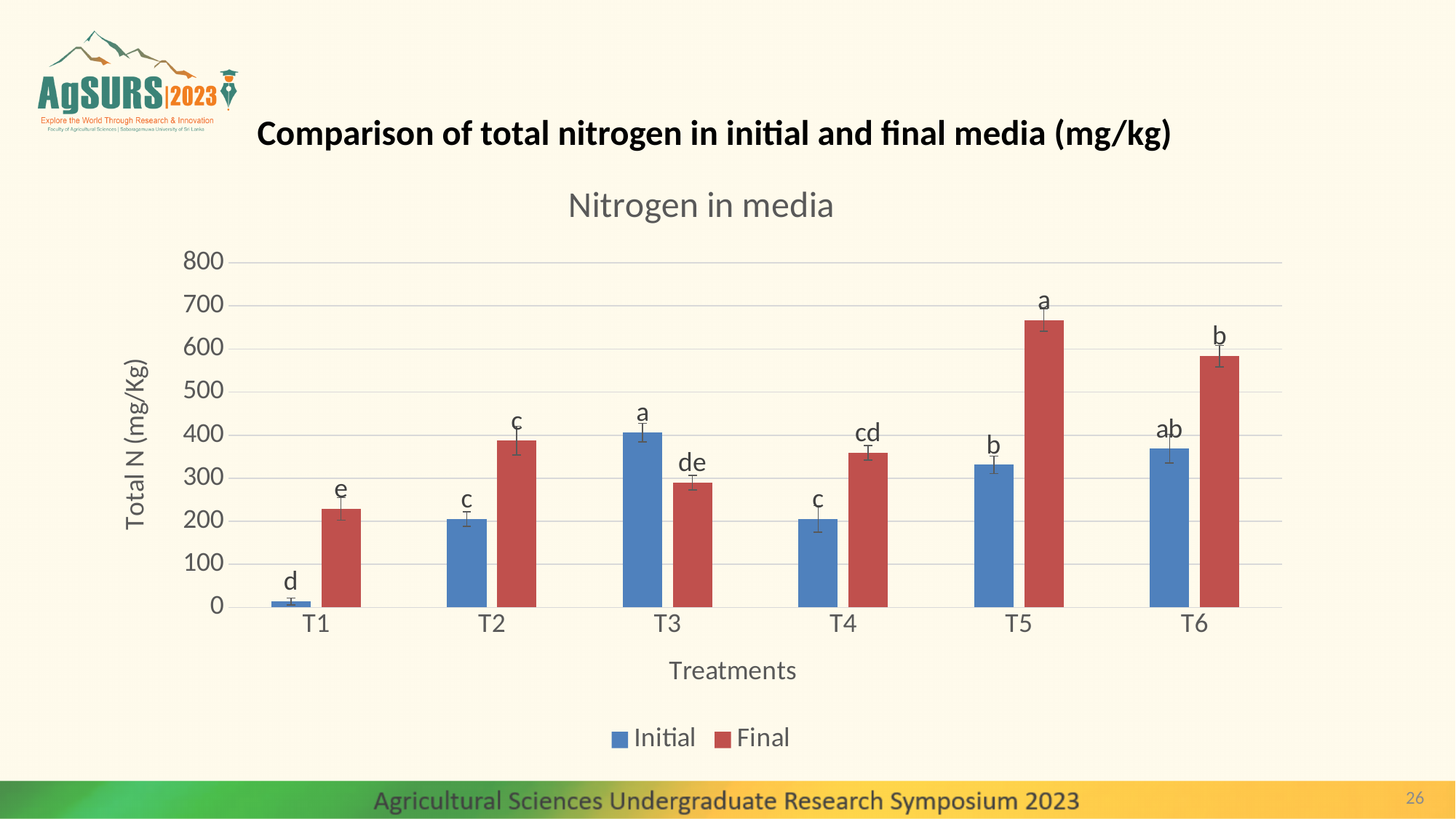
Is the Initial value for T1 greater or less than 100? less How many series does the chart legend list? 2 Which treatment has the lowest Final total nitrogen value? T1 For T3, which is larger, the Initial or the Final value? Initial Is the Final value for T5 greater or less than 600? greater What type of chart is shown on the slide? bar chart Which treatment has the highest Initial total nitrogen value? T3 What is the label of the y axis of the chart? Total N (mg/Kg) Which treatment has the lowest Initial total nitrogen value? T1 How many treatments are shown on the x axis of the chart? 6 Which treatment has the highest Final total nitrogen value? T5 Is the Final value for T6 greater or less than 500? greater